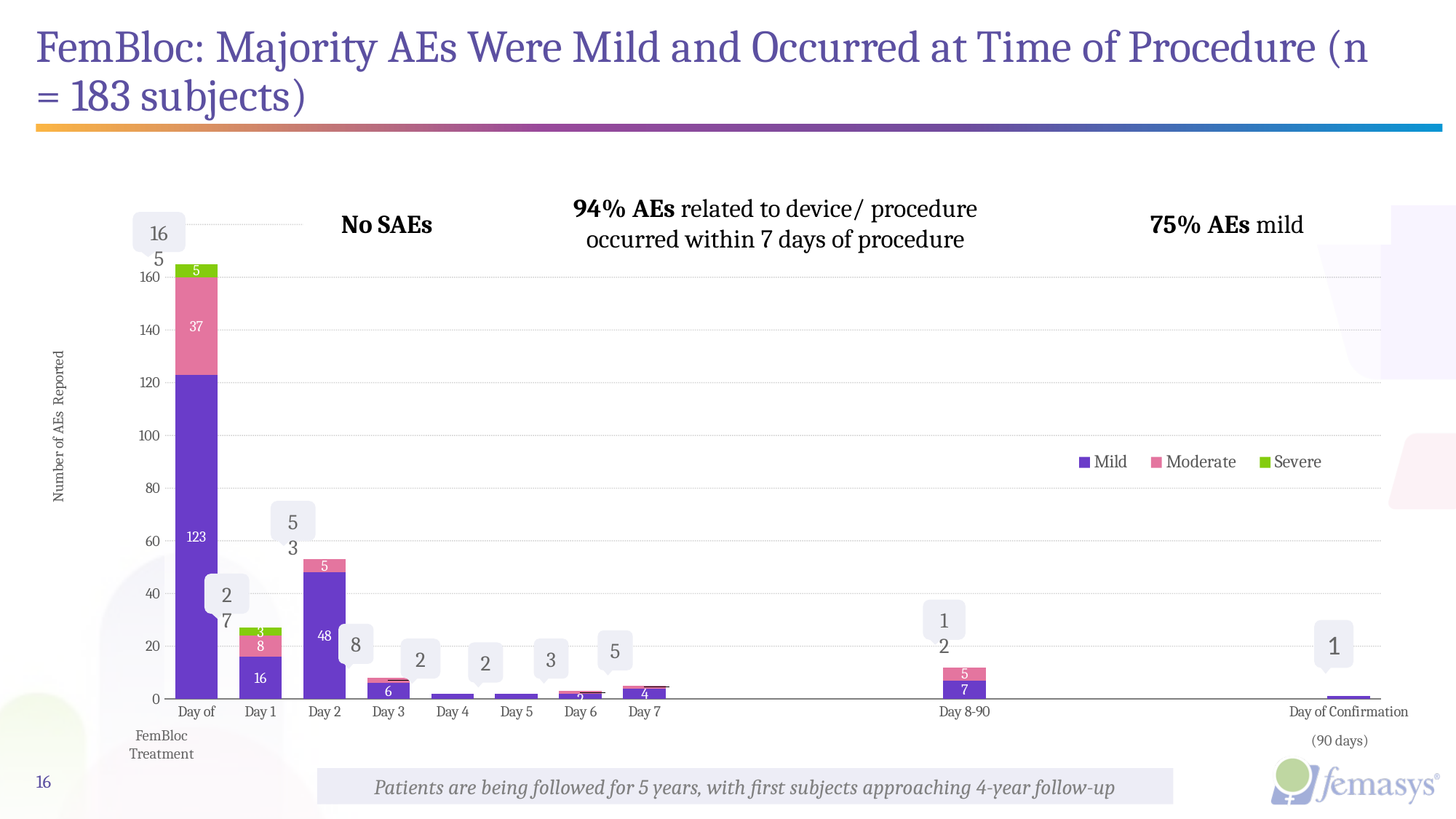
How many series does the legend list? 3 How many Mild AEs were reported on Day 2? 48 How many time-point categories are shown on the x axis? 10 What is the total number of AEs reported on Day 1 (Mild + Moderate + Severe)? 27 Is the total number of AEs reported on Day 2 greater or less than 40? greater Which time point has the highest number of AEs reported? Day of FemBloc Treatment Which has more Mild AEs, Day 1 or Day 2? Day 2 What is the difference between the Mild AEs on the Day of FemBloc Treatment and the Mild AEs on Day 2? 75 How many Moderate AEs were reported on the Day of FemBloc Treatment? 37 How many Mild AEs were reported on the Day of FemBloc Treatment? 123 How many Severe AEs were reported on Day 1? 3 How many Moderate AEs were reported on Day 8-90? 5